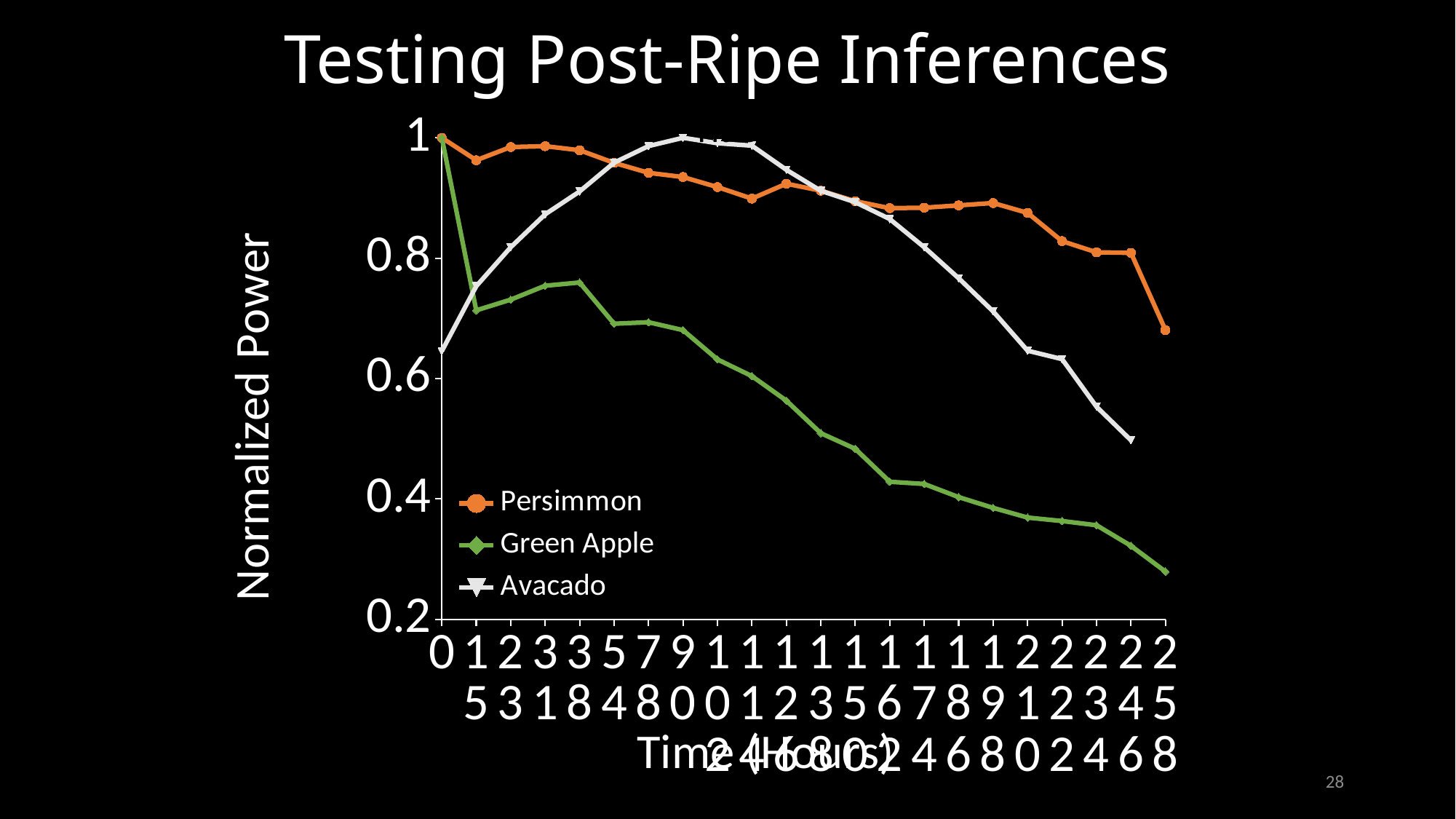
What is the label of the y axis? Normalized Power Which series has the lowest Normalized Power at the final time point? Green Apple How many series does the legend list? 3 Is the final Normalized Power value for Green Apple greater or less than 0.4? less Does the Persimmon series rise or fall overall along the x axis? fall What is the Normalized Power of Persimmon at time 0? 1 What kind of chart is shown on the slide? line chart What is the Normalized Power of Green Apple at time 0? 1 Does the Green Apple series rise or fall overall along the x axis? fall Which series has the lowest Normalized Power at time 0? Avacado At the final time point, which series has the higher Normalized Power, Persimmon or Avacado? Persimmon Which series are listed in the legend? Persimmon, Green Apple, Avacado